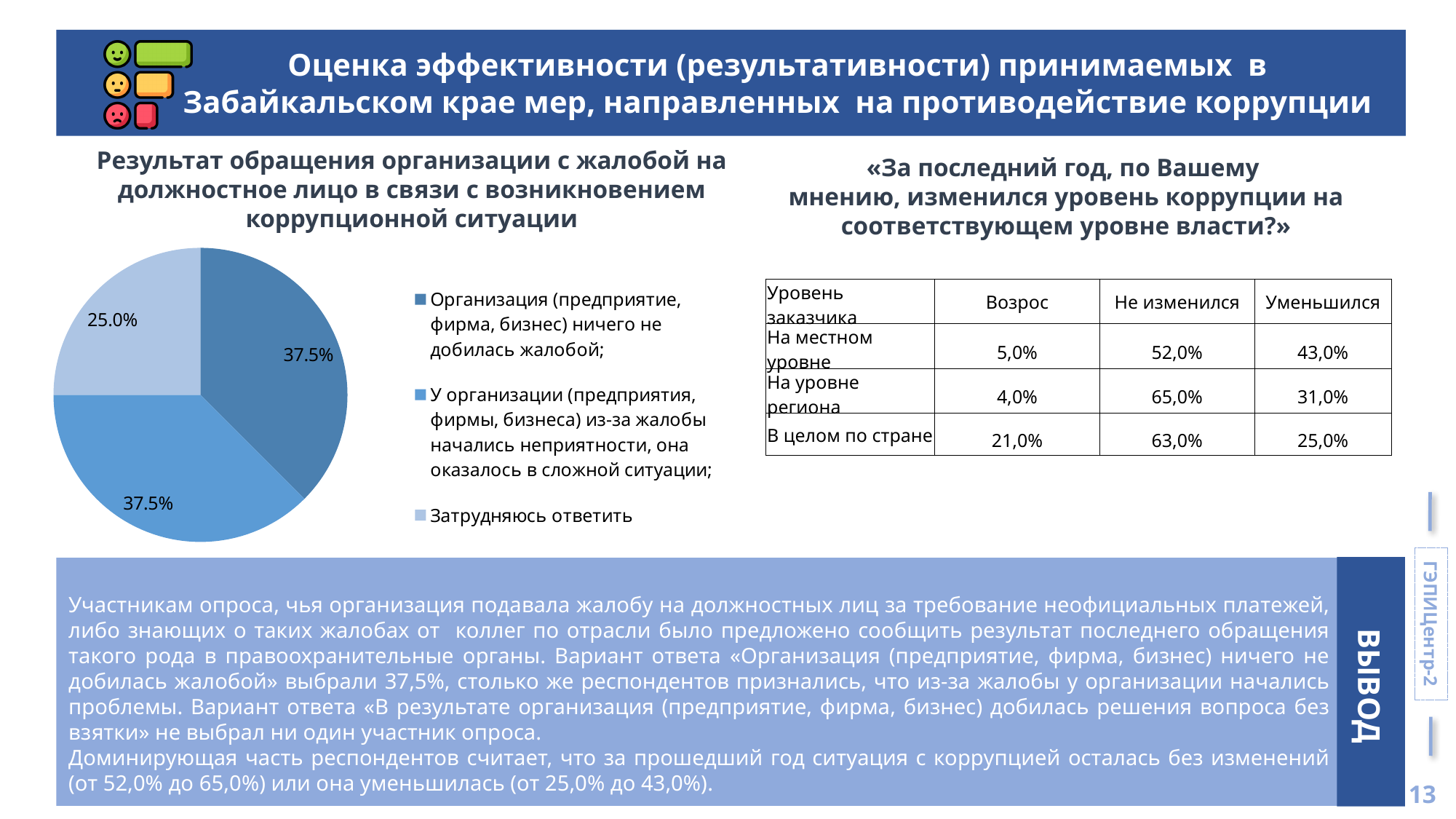
In the pie chart, what is the difference between the share for "Организация (предприятие, фирма, бизнес) ничего не добилась жалобой" and the share for "Затрудняюсь ответить"? 12.5% What kind of chart is shown on the left of the slide? Pie chart In the pie chart, which legend entry is shown in the lightest blue colour? Затрудняюсь ответить Which answer option has the smallest slice in the pie chart? Затрудняюсь ответить How many entries does the legend of the pie chart list? 3 How many slices does the pie chart have? 3 What is the title of the pie chart on the left of the slide? Результат обращения организации с жалобой на должностное лицо в связи с возникновением коррупционной ситуации In the pie chart, which is larger: the slice for "Затрудняюсь ответить" or the slice for "Организация (предприятие, фирма, бизнес) ничего не добилась жалобой"? Организация (предприятие, фирма, бизнес) ничего не добилась жалобой In the pie chart, what share of respondents chose "Организация (предприятие, фирма, бизнес) ничего не добилась жалобой"? 37.5% In the pie chart, what share of respondents chose "Затрудняюсь ответить"? 25.0% In the pie chart, is the share for "Затрудняюсь ответить" greater or less than 30%? less In the pie chart, what share of respondents chose "У организации (предприятия, фирмы, бизнеса) из-за жалобы начались неприятности, она оказалось в сложной ситуации"? 37.5%